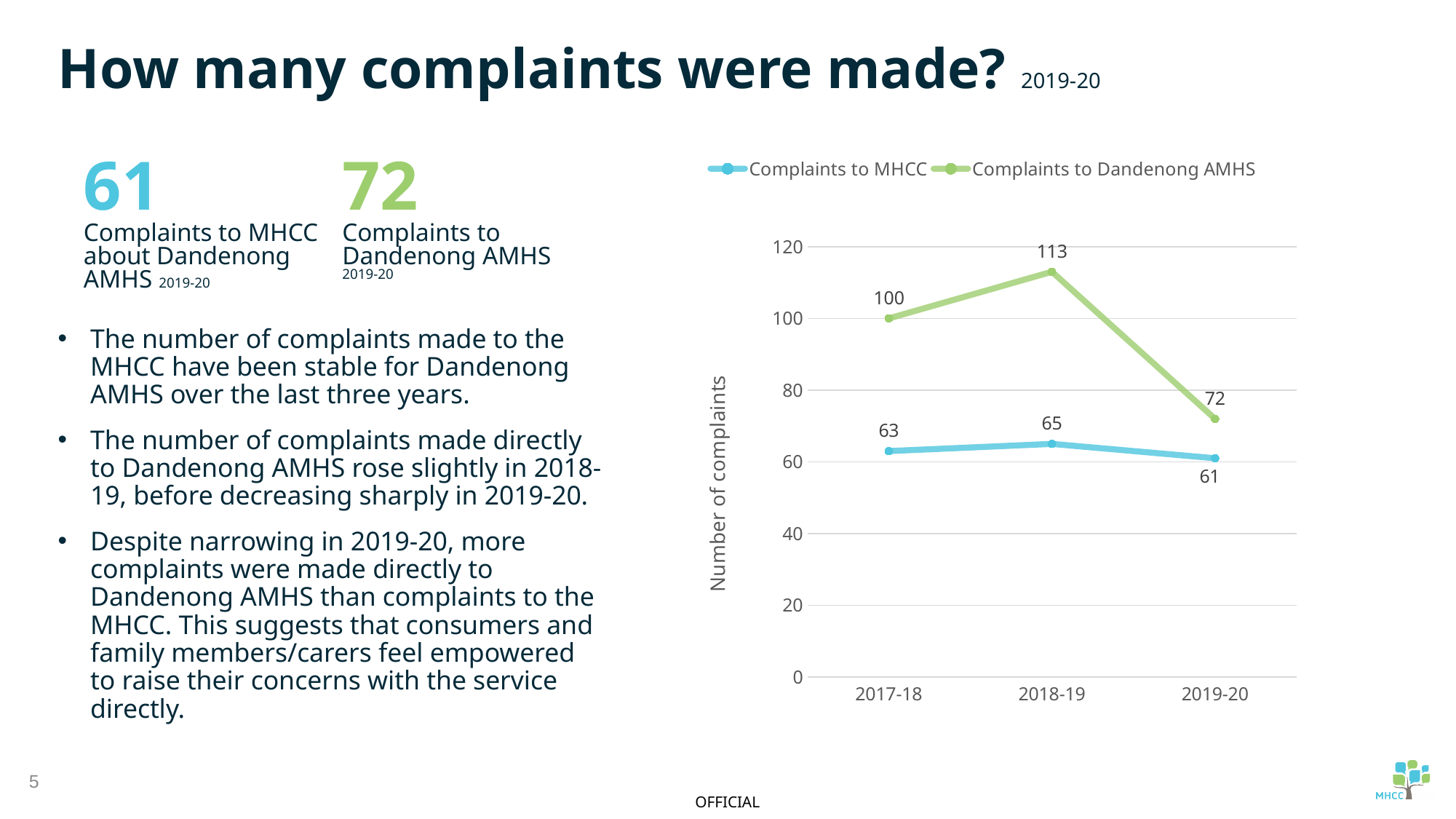
In which year were complaints to Dandenong AMHS lowest? 2019-20 In which year were complaints to Dandenong AMHS highest? 2018-19 Which series had the larger value in 2017-18, Complaints to MHCC or Complaints to Dandenong AMHS? Complaints to Dandenong AMHS What was the number of complaints to MHCC in 2019-20? 61 What is the label on the vertical axis of the chart? Number of complaints What was the number of complaints to MHCC in 2017-18? 63 Did complaints to Dandenong AMHS rise or fall from 2018-19 to 2019-20? Fall What was the number of complaints to Dandenong AMHS in 2018-19? 113 What is the difference between complaints to Dandenong AMHS and complaints to MHCC in 2019-20? 11 How many years are plotted on the x axis of the chart? 3 How many series does the chart legend list? 2 What type of chart is shown on the slide? Line chart